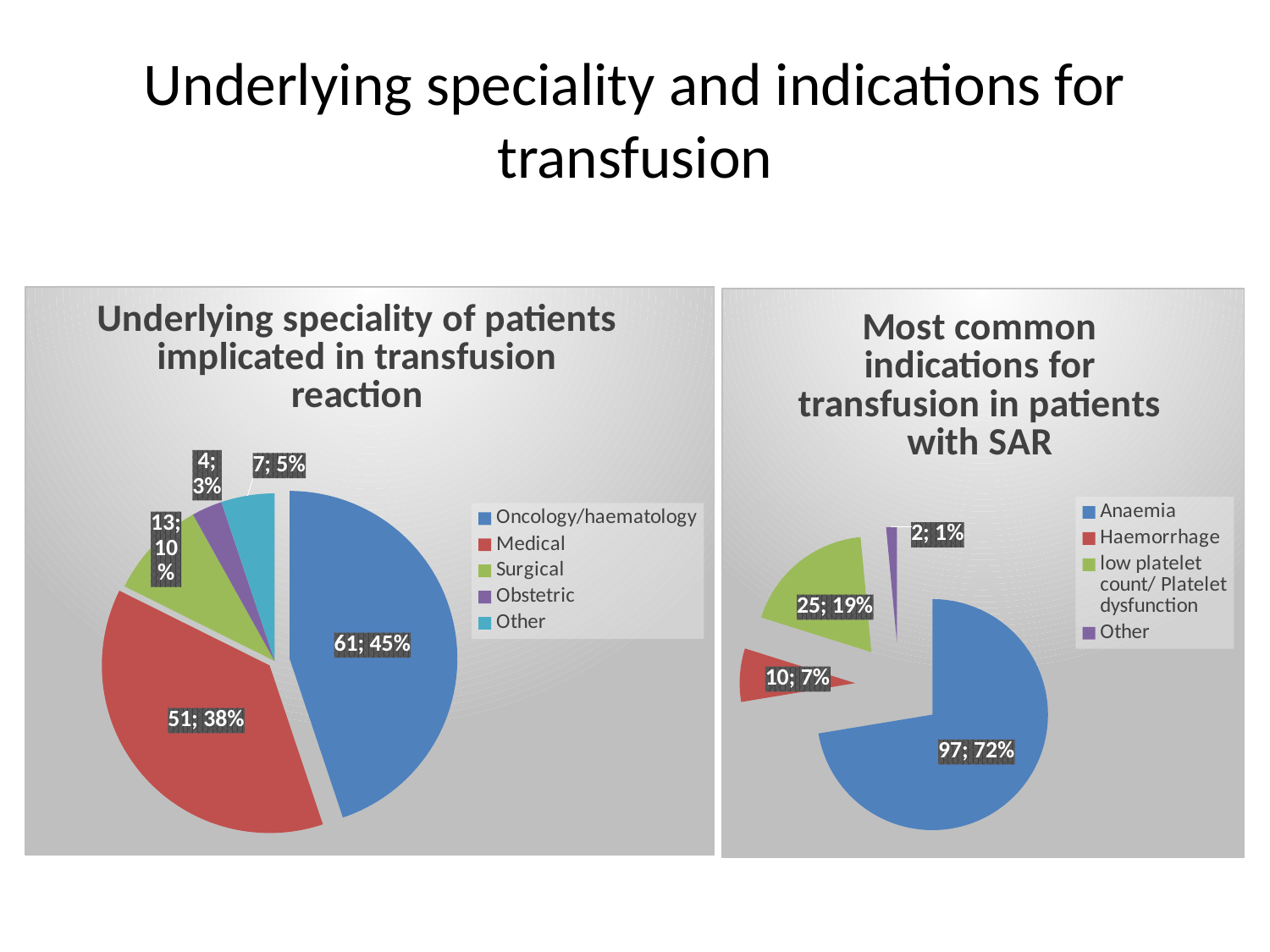
What type of chart is the 'Most common indications for transfusion in patients with SAR' chart? Pie chart In the 'Most common indications for transfusion in patients with SAR' chart, what is the count for Anaemia? 97 In the 'Underlying speciality of patients implicated in transfusion reaction' chart, which is larger, Surgical or Other? Surgical In the 'Most common indications for transfusion in patients with SAR' chart, what percentage share does low platelet count/ Platelet dysfunction have? 19% In the 'Underlying speciality of patients implicated in transfusion reaction' chart, what is the count for Medical? 51 In the 'Most common indications for transfusion in patients with SAR' chart, what colour is the Haemorrhage slice? Red In the 'Most common indications for transfusion in patients with SAR' chart, which indication has the largest slice? Anaemia In the 'Underlying speciality of patients implicated in transfusion reaction' chart, what is the difference between the Oncology/haematology count and the Medical count? 10 In the 'Most common indications for transfusion in patients with SAR' chart, what is the difference between the Haemorrhage count and the Other count? 8 In the 'Underlying speciality of patients implicated in transfusion reaction' chart, which speciality has the smallest slice? Obstetric In the 'Underlying speciality of patients implicated in transfusion reaction' chart, how many categories does the legend list? 5 In the 'Underlying speciality of patients implicated in transfusion reaction' chart, what percentage share does Oncology/haematology have? 45%